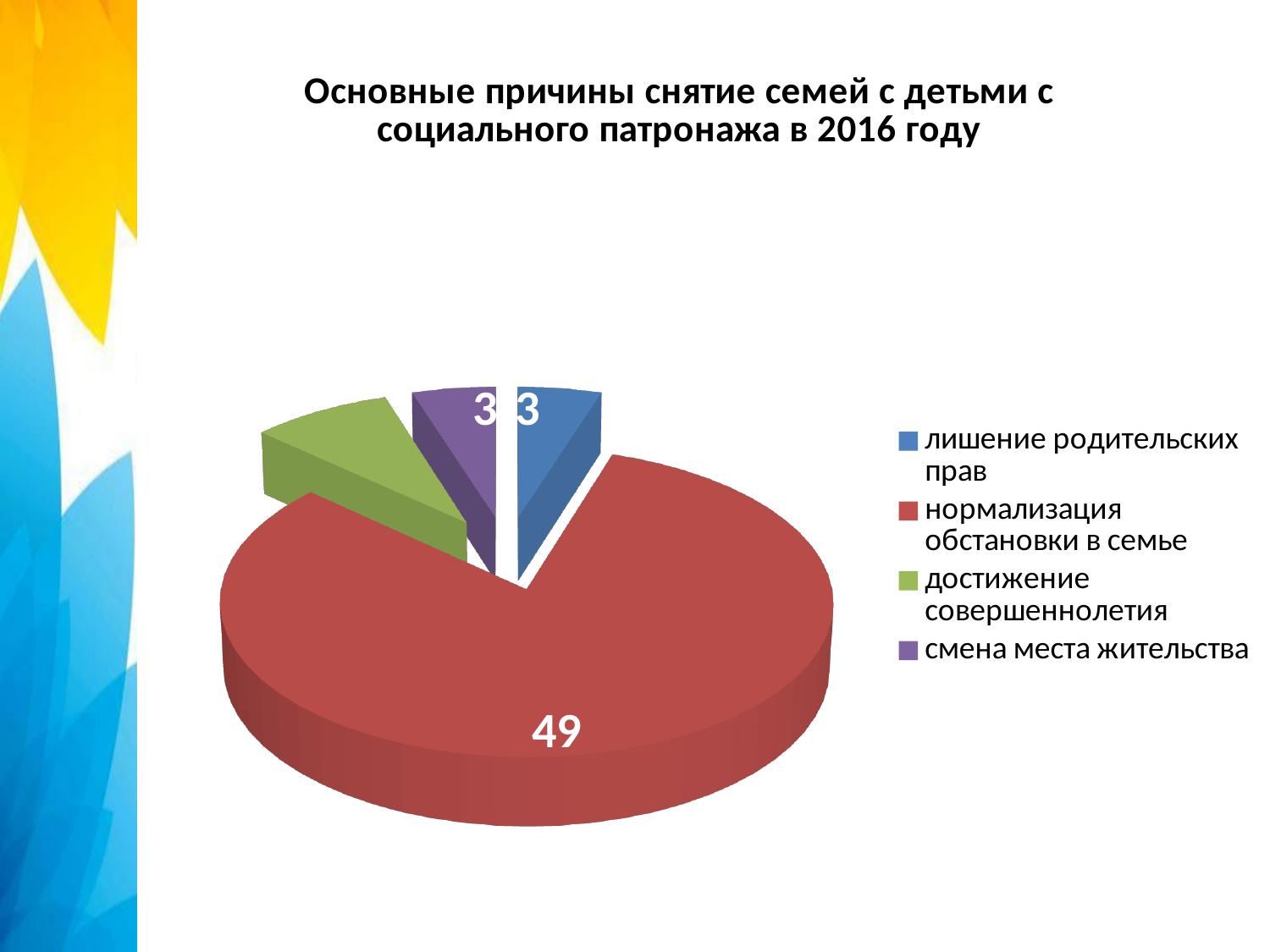
How many categories does the pie chart have? 4 What is the title of the chart? Основные причины снятие семей с детьми с социального патронажа в 2016 году Which category is shown in red in the legend? нормализация обстановки в семье What is the value for "нормализация обстановки в семье"? 49 Which is larger: "нормализация обстановки в семье" or "достижение совершеннолетия"? нормализация обстановки в семье Which is larger: "достижение совершеннолетия" or "лишение родительских прав"? достижение совершеннолетия What is the value for "смена места жительства"? 3 What is the difference between the values for "нормализация обстановки в семье" and "лишение родительских прав"? 46 What kind of chart is shown on the slide? pie chart What is the value for "лишение родительских прав"? 3 Which category has the largest slice of the pie? нормализация обстановки в семье